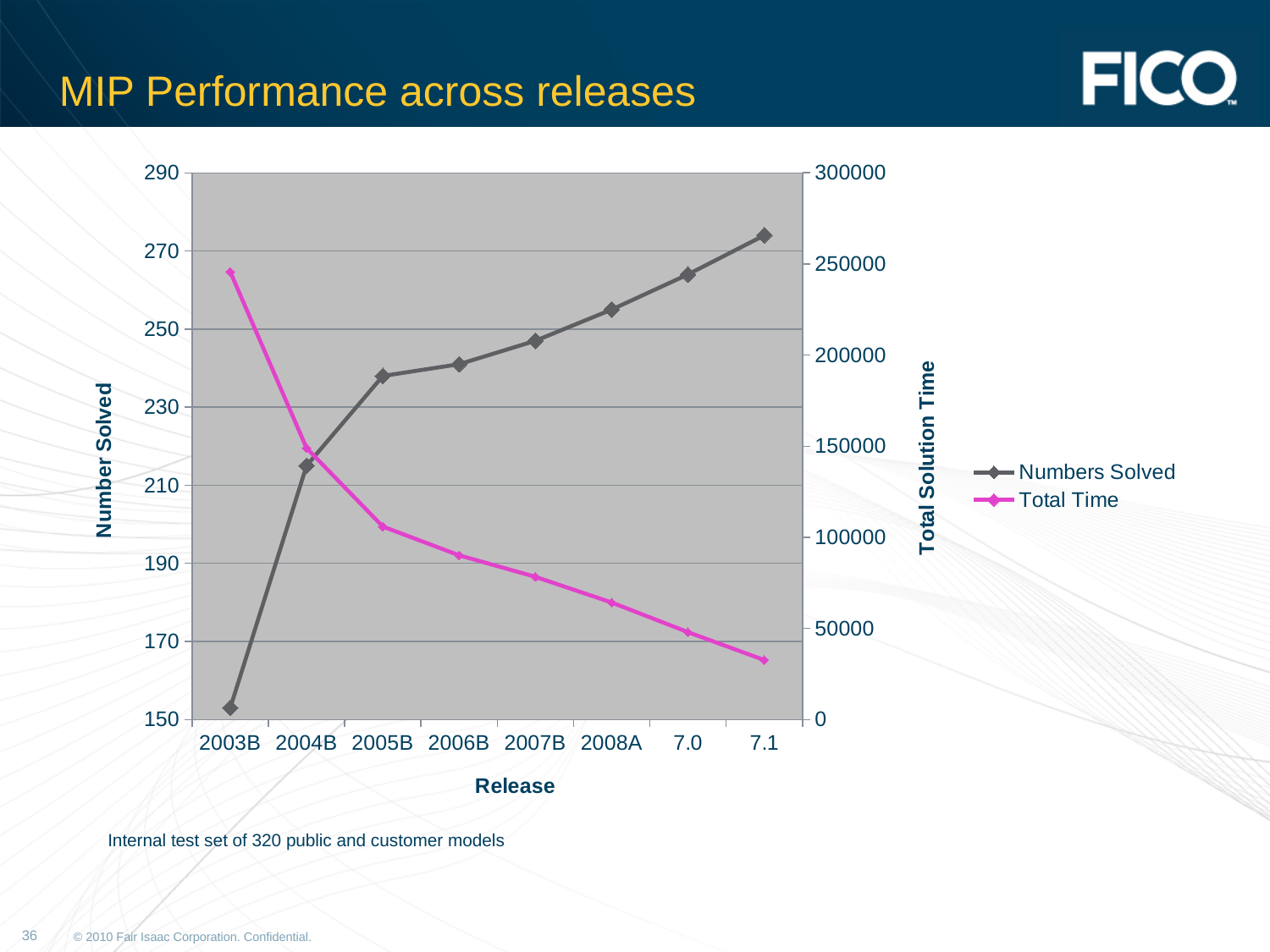
How many series does the legend list? 2 What is the title of the x axis? Release Is the Numbers Solved value for 2003B greater or less than 170? less Which release has the lowest Total Time? 7.1 Which release has the highest value for Numbers Solved? 7.1 What kind of chart is shown on the slide? Line chart Does the Total Time series rise or fall across the releases from 2003B to 7.1? Fall Which release has the highest Total Time? 2003B Which release has the lowest value for Numbers Solved? 2003B Is the Total Time value for 2003B greater or less than 200000? greater How many releases are shown on the x axis? 8 Does the Numbers Solved series rise or fall across the releases from 2003B to 7.1? Rise